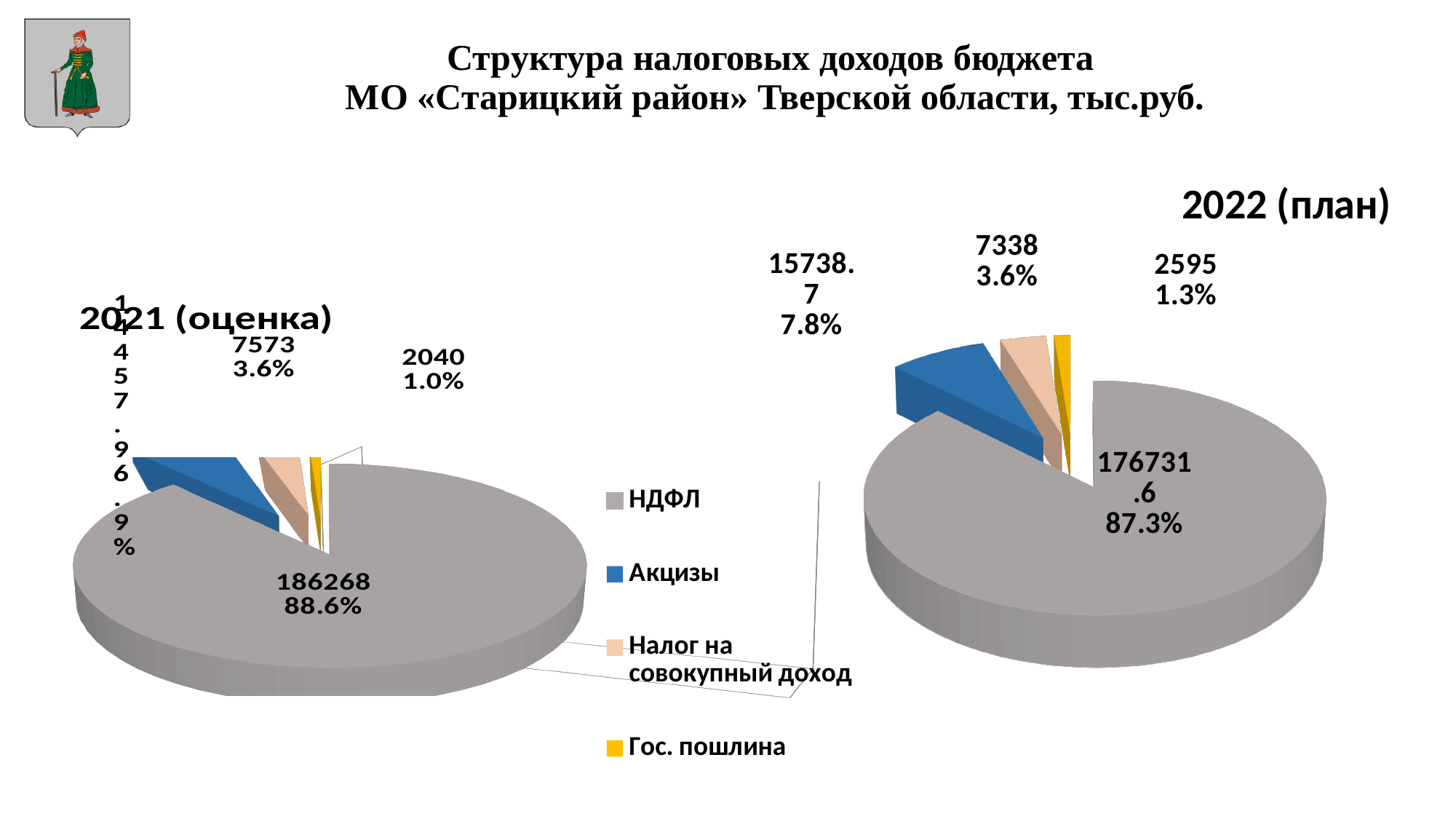
In the 2022 (план) chart, what value is shown for НДФЛ? 176731.6 In the 2022 (план) chart, what is the difference between the values for Акцизы and Налог на совокупный доход? 8400.7 In the 2022 (план) chart, which category has the smallest slice? Гос. пошлина In the 2022 (план) chart, what share of the pie does Акцизы have? 7.8% In the 2021 (оценка) chart, which category has the largest slice? НДФЛ What kind of chart is the 2022 (план) chart? pie chart In the 2021 (оценка) chart, what share of the pie does Гос. пошлина have? 1.0% In the 2021 (оценка) chart, what value is shown for Налог на совокупный доход? 7573 How many series does the legend list? 4 Which is larger: the value for Гос. пошлина in the 2021 (оценка) chart or in the 2022 (план) chart? 2022 (план) Which colour represents Акцизы in the legend? blue In the 2022 (план) chart, what share of the pie does НДФЛ have? 87.3%